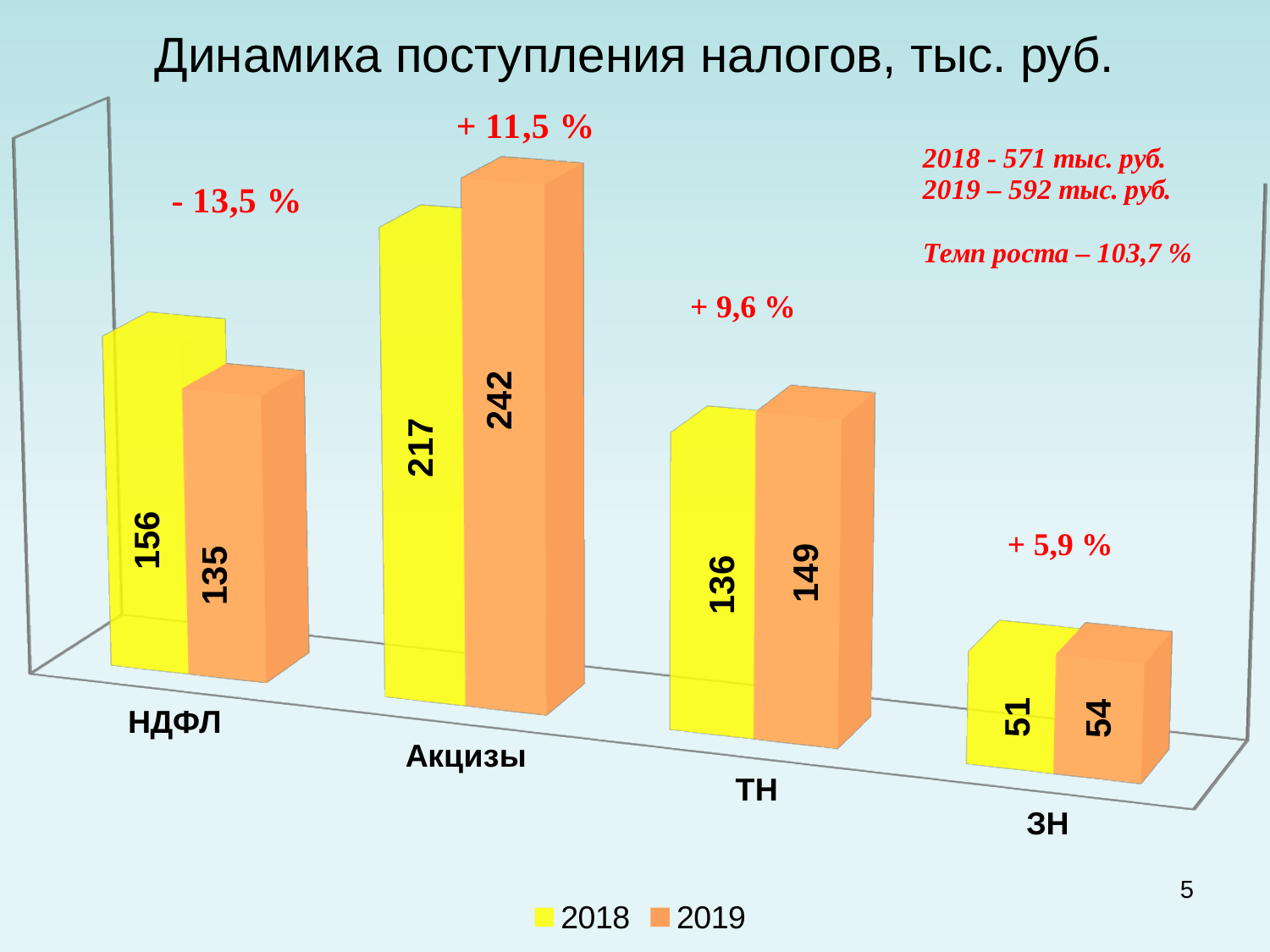
Which is larger for НДФЛ: the 2018 value or the 2019 value? 2018 What kind of chart is shown on the slide? Bar chart Which category has the highest value in 2019? Акцизы What is the value for НДФЛ in 2018? 156 How many series does the legend list? 2 Which category has the lowest value in 2018? ЗН How many categories are shown on the x axis? 4 What is the title of the chart? Динамика поступления налогов, тыс. руб. What is the value for ТН in 2019? 149 What is the value for Акцизы in 2019? 242 What is the value for ЗН in 2018? 51 What is the difference between the 2019 and 2018 values for Акцизы? 25